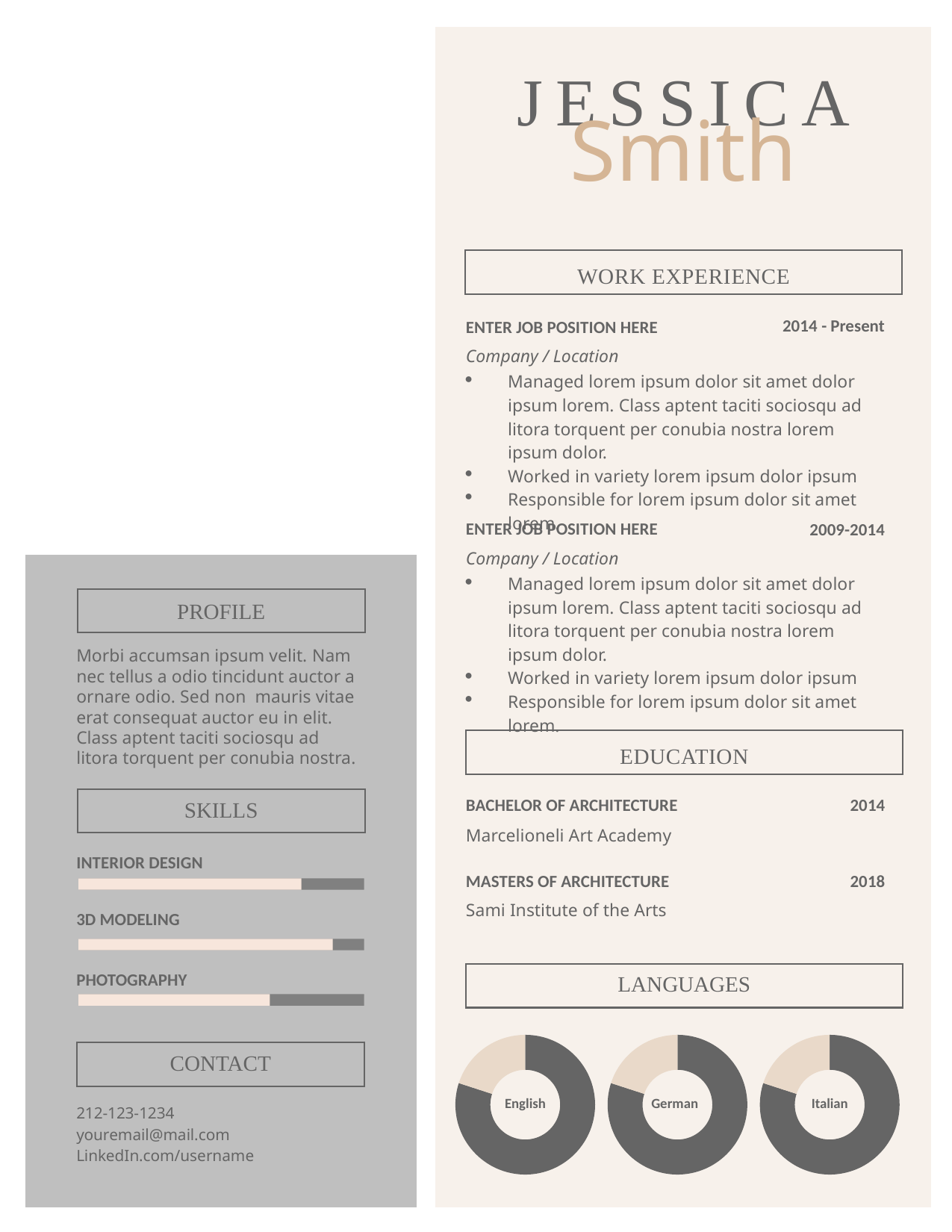
In the German doughnut chart, is the dark grey segment larger or smaller than the beige segment? larger What two colours are used for the segments of the language doughnut charts? dark grey and beige Which language is labelled in the middle doughnut chart? German In the Italian doughnut chart, is the beige segment larger or smaller than the dark grey segment? smaller In the English doughnut chart, is the dark grey segment larger or smaller than the beige segment? larger How many segments does the English doughnut chart have? 2 How many charts are shown in the Languages section? 3 What kind of chart is used in the Languages section? doughnut (pie) chart